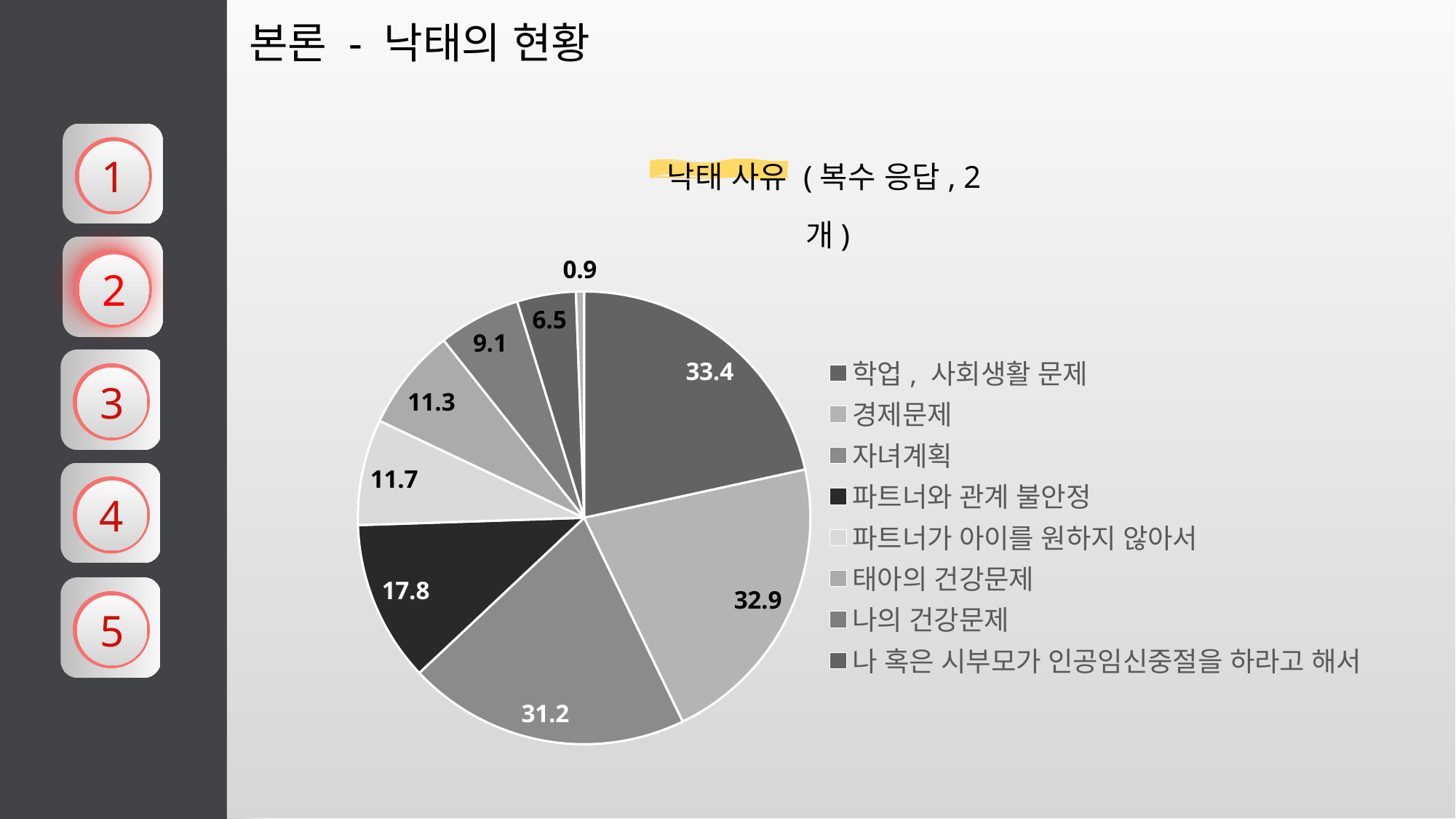
What is the difference between the values for 학업, 사회생활 문제 and 파트너와 관계 불안정? 15.6 What is the value for 태아의 건강문제? 11.3 Which category has the highest value? 학업, 사회생활 문제 Which is larger, the value for 나의 건강문제 or the value for 나 혹은 시부모가 인공임신중절을 하라고 해서? 나의 건강문제 How many entries does the legend list? 8 What type of chart is shown on the slide? pie chart What is the value for 자녀계획? 31.2 What is the value for 파트너와 관계 불안정? 17.8 What is the smallest value printed on the pie chart? 0.9 What is the value for 경제문제? 32.9 What is the value for 학업, 사회생활 문제? 33.4 What is the title of the chart? 낙태 사유 (복수 응답, 2개)